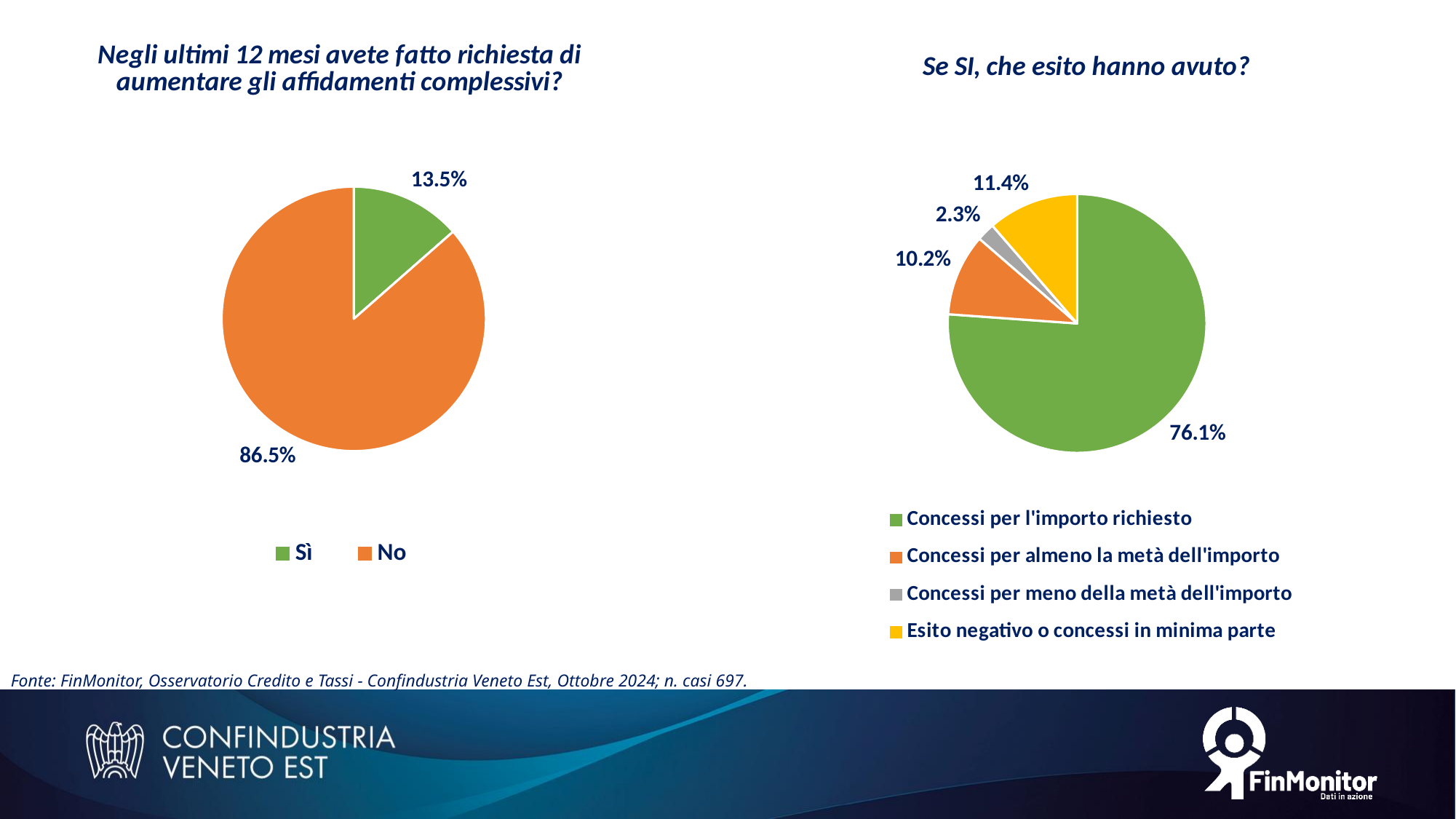
In the right pie chart, which category has the smallest share? Concessi per meno della metà dell'importo In the left pie chart, which answer has the larger share, 'Sì' or 'No'? No In the left pie chart, what is the difference in percentage points between 'No' and 'Sì'? 73.0 percentage points In the right pie chart ('Se SI, che esito hanno avuto?'), what share corresponds to 'Concessi per l'importo richiesto'? 76.1% How many categories does the legend of the right pie chart list? 4 In the left pie chart ('Negli ultimi 12 mesi avete fatto richiesta di aumentare gli affidamenti complessivi?'), what share of respondents answered 'Sì'? 13.5% In the left pie chart, what share of respondents answered 'No'? 86.5% In the right pie chart, which category has the largest share? Concessi per l'importo richiesto In the right pie chart, what colour is the slice for 'Esito negativo o concessi in minima parte'? Yellow In the right pie chart, what share corresponds to 'Concessi per almeno la metà dell'importo'? 10.2% In the right pie chart, what share corresponds to 'Esito negativo o concessi in minima parte'? 11.4% What type of chart is used on the left side of the slide? Pie chart